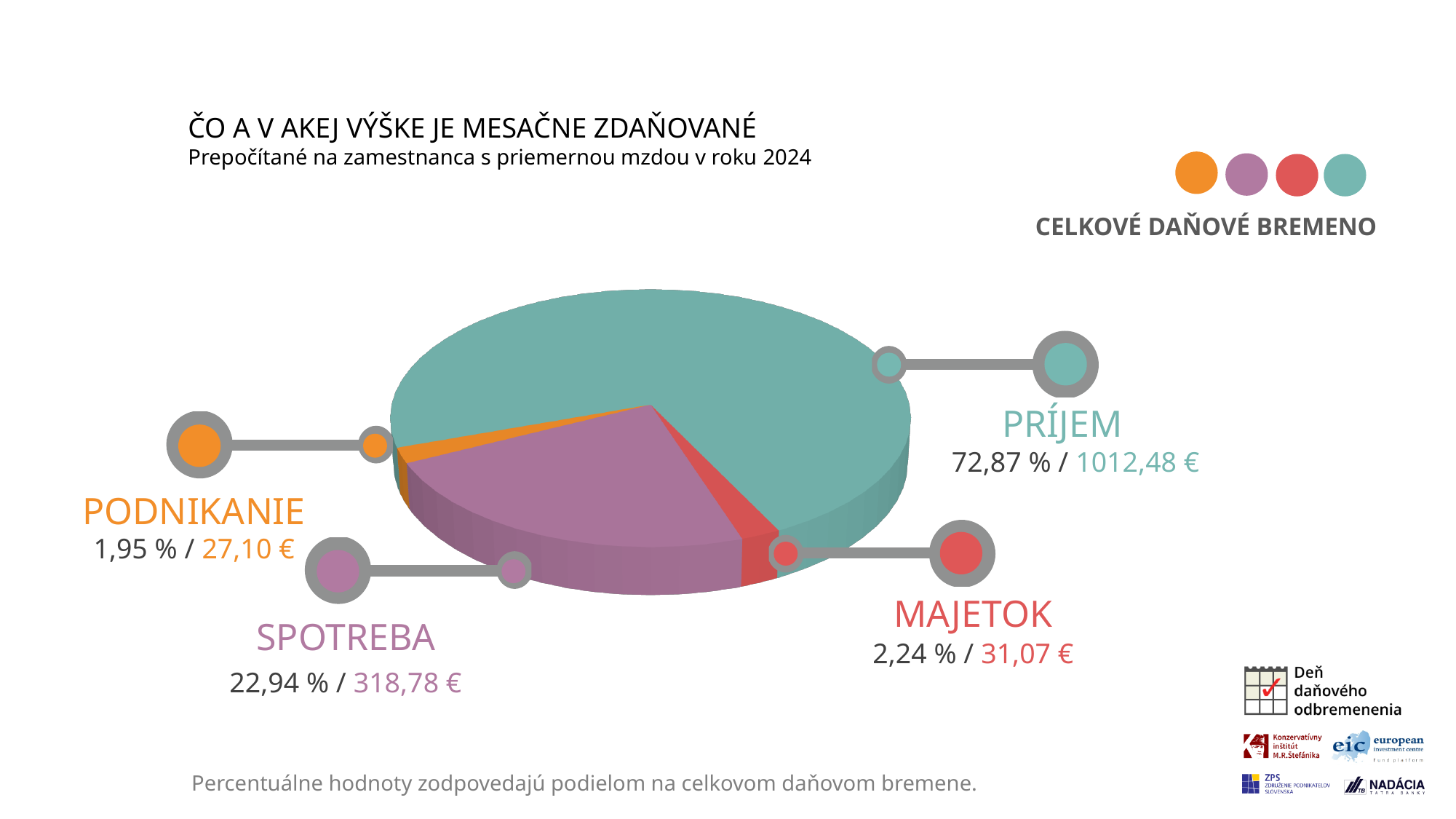
What monthly amount in euros is shown for SPOTREBA? 318,78 € Which category has the largest share of the pie? PRÍJEM What percentage share is shown for PRÍJEM? 72,87 % What is the difference in percentage points between the PRÍJEM share and the SPOTREBA share? 49,93 % What is the title of the chart? ČO A V AKEJ VÝŠKE JE MESAČNE ZDAŇOVANÉ What kind of chart is shown on the slide? pie chart How many slices does the pie chart have? 4 Which is larger, the amount for MAJETOK or the amount for PODNIKANIE? MAJETOK What is the difference in euros between the PRÍJEM amount and the SPOTREBA amount? 693,70 € What percentage share is shown for MAJETOK? 2,24 % Which category has the smallest share of the pie? PODNIKANIE What monthly amount in euros is shown for PODNIKANIE? 27,10 €